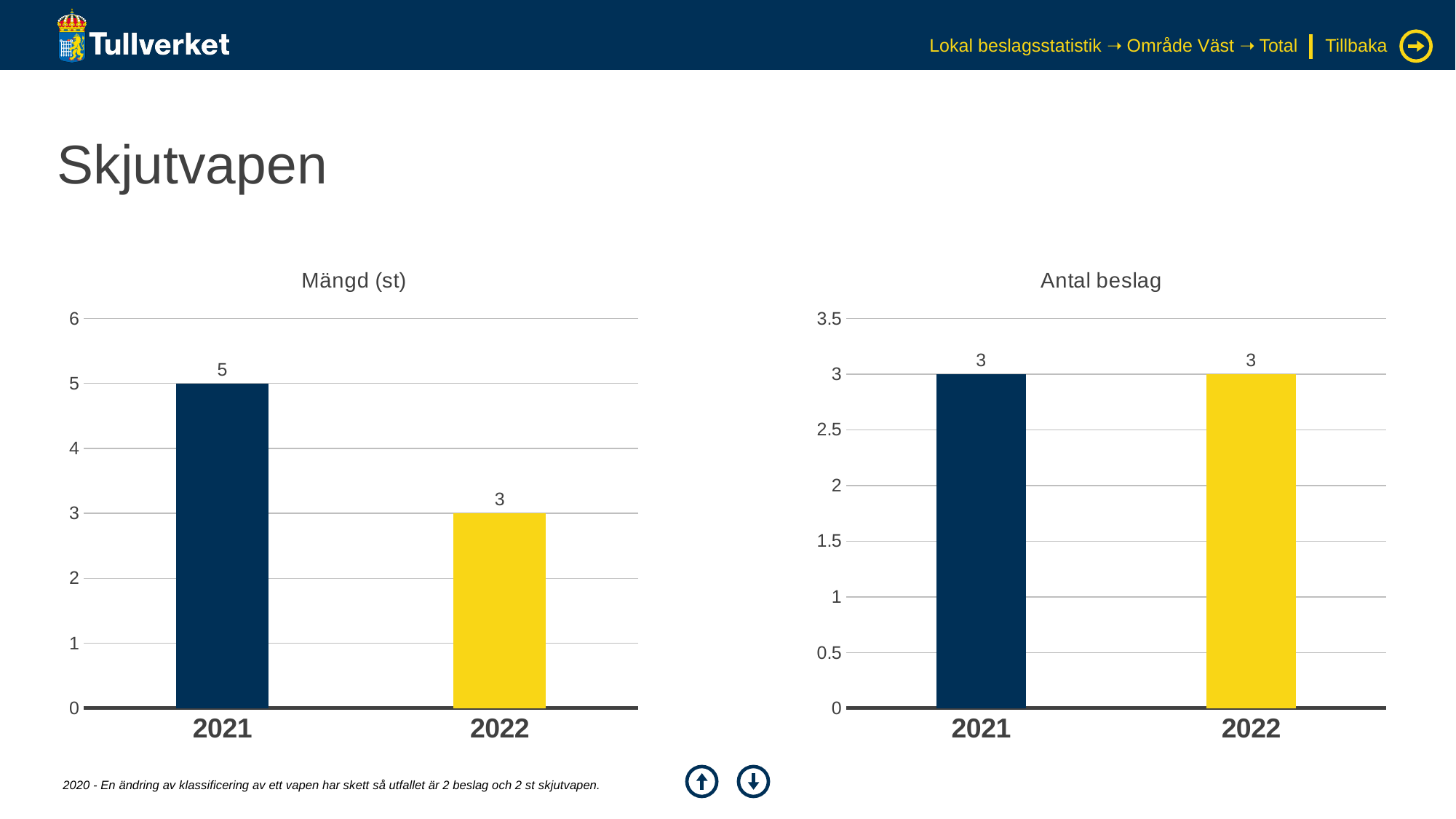
In the 'Mängd (st)' chart, what is the value for 2021? 5 In the 'Mängd (st)' chart, is the value for 2021 greater or less than 4? greater In the 'Mängd (st)' chart, what is the difference between the values for 2021 and 2022? 2 In the 'Mängd (st)' chart, which year has the highest value? 2021 How many categories are shown in the 'Antal beslag' chart? 2 What kind of chart is the 'Antal beslag' chart? bar chart In the 'Mängd (st)' chart, which year has the lowest value? 2022 In the 'Antal beslag' chart, what is the value for 2022? 3 In the 'Mängd (st)' chart, which is larger, the value for 2021 or the value for 2022? 2021 In the 'Mängd (st)' chart, do the values rise or fall from 2021 to 2022? fall In the 'Mängd (st)' chart, what is the value for 2022? 3 In the 'Antal beslag' chart, what is the value for 2021? 3